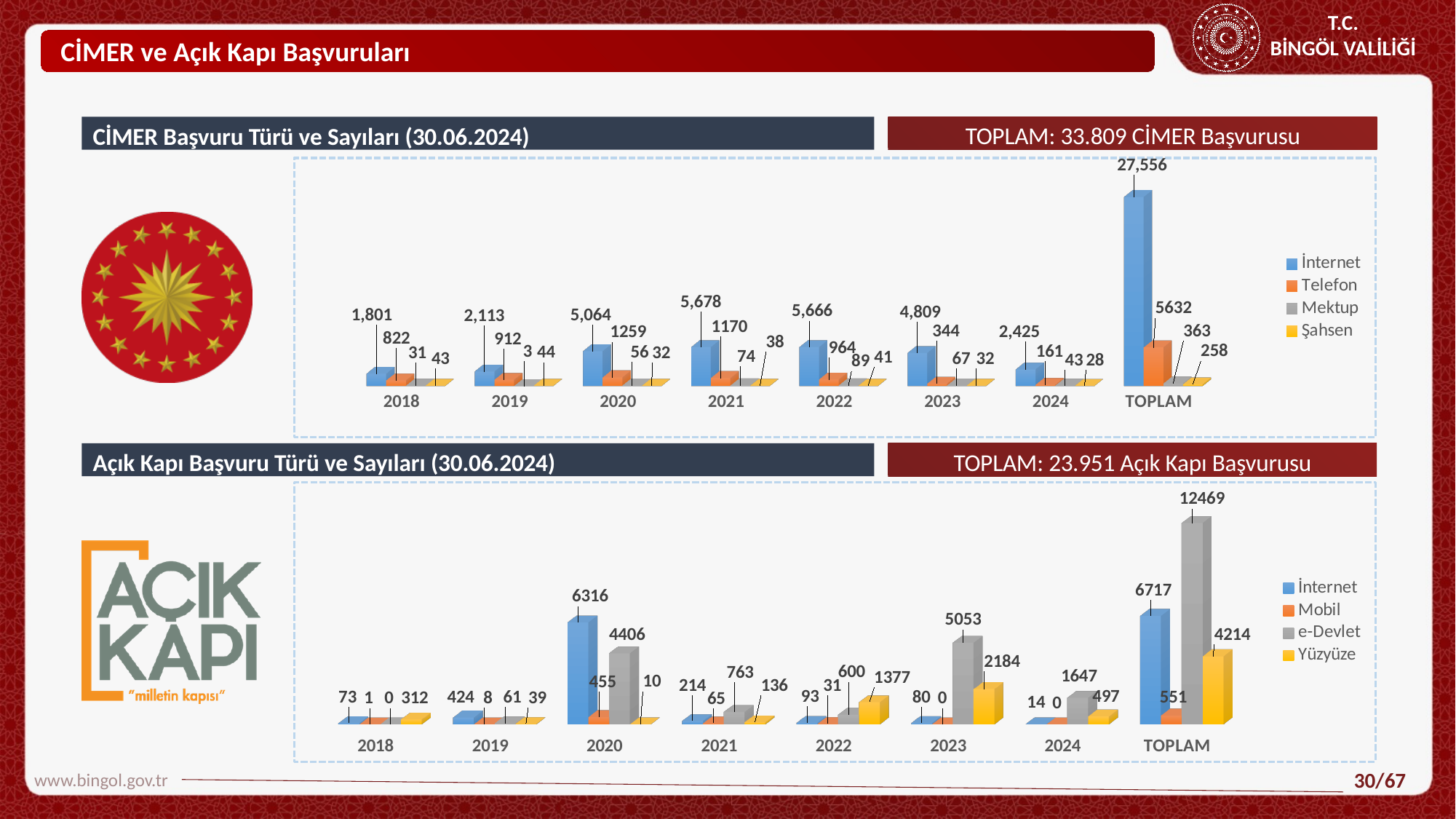
In the Açık Kapı Başvuru Türü ve Sayıları chart, which series has the highest TOPLAM value? e-Devlet In the Açık Kapı Başvuru Türü ve Sayıları chart, what is the difference between the Yüzyüze values for 2023 and 2022? 807 In the Açık Kapı Başvuru Türü ve Sayıları chart, how many categories are shown on the x axis? 8 In the CİMER Başvuru Türü ve Sayıları chart, what is the Telefon value for 2020? 1259 In the CİMER Başvuru Türü ve Sayıları chart, which year (excluding TOPLAM) has the highest İnternet value? 2021 In the CİMER Başvuru Türü ve Sayıları chart, how many series does the legend list? 4 In the CİMER Başvuru Türü ve Sayıları chart, what is the İnternet value for 2021? 5,678 In the CİMER Başvuru Türü ve Sayıları chart, what is the TOPLAM value for Mektup? 363 What type of chart is the Açık Kapı Başvuru Türü ve Sayıları chart? Bar chart In the Açık Kapı Başvuru Türü ve Sayıları chart, is the İnternet value for 2020 larger or the e-Devlet value for 2020? İnternet In the CİMER Başvuru Türü ve Sayıları chart, what is the difference between the İnternet values for 2020 and 2024? 2,639 In the Açık Kapı Başvuru Türü ve Sayıları chart, what is the e-Devlet value for 2023? 5053